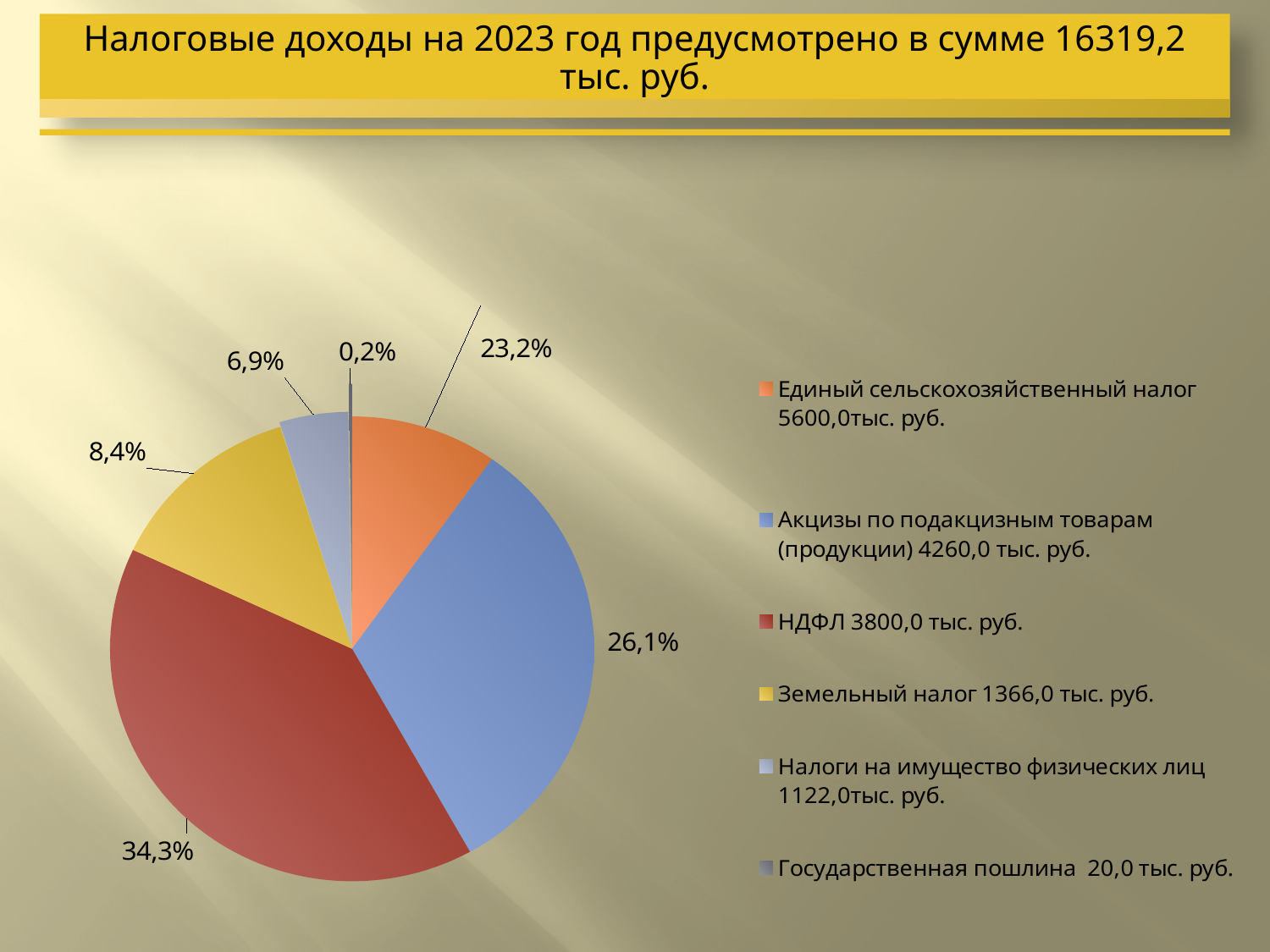
What kind of chart is shown on the slide? pie chart Which category has the largest share of the pie? НДФЛ According to the legend, what amount in тыс. руб. is given for Земельный налог? 1366,0 тыс. руб. How many slices does the pie chart have? 6 What is the difference in percentage points between the shares of НДФЛ and Акцизы по подакцизным товарам (продукции)? 8,2 What share of the pie does Акцизы по подакцизным товарам (продукции) account for? 26,1% Which category has the smallest share of the pie? Государственная пошлина What share of the pie does НДФЛ account for? 34,3% What share of the pie does Государственная пошлина account for? 0,2% Which has a larger share: Земельный налог or Налоги на имущество физических лиц? Земельный налог